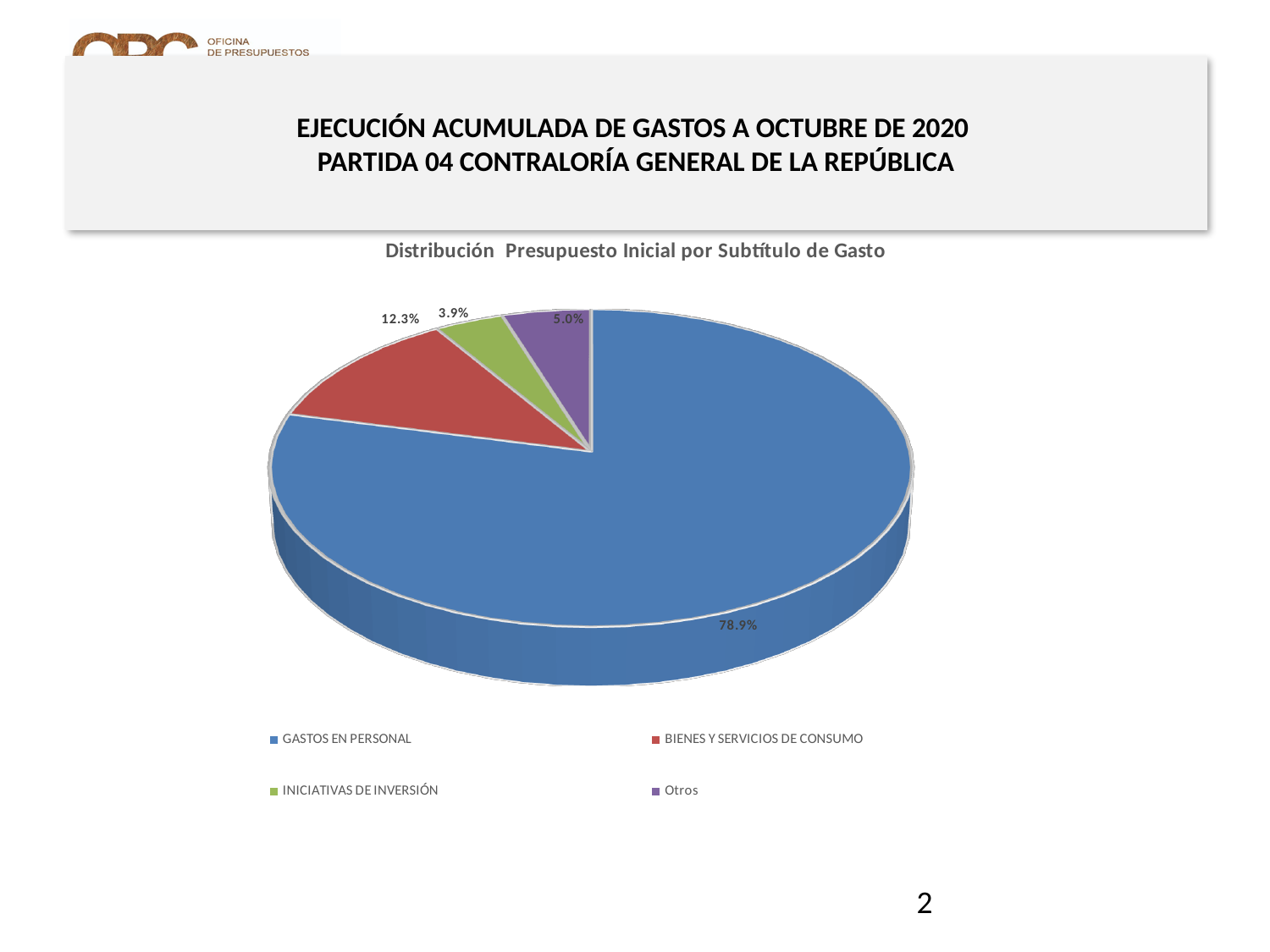
What share of the pie does Otros represent? 5.0% What is the title of the chart? Distribución Presupuesto Inicial por Subtítulo de Gasto Which is larger, the share for Otros or the share for INICIATIVAS DE INVERSIÓN? Otros How many categories does the pie chart show? 4 What share of the pie does BIENES Y SERVICIOS DE CONSUMO represent? 12.3% What share of the pie does GASTOS EN PERSONAL represent? 78.9% Which category has the smallest share of the pie? INICIATIVAS DE INVERSIÓN What is the difference in percentage points between GASTOS EN PERSONAL and BIENES Y SERVICIOS DE CONSUMO? 66.6 percentage points Which colour represents BIENES Y SERVICIOS DE CONSUMO in the legend? Red Which category has the largest share of the pie? GASTOS EN PERSONAL What type of chart is shown on the slide? Pie chart